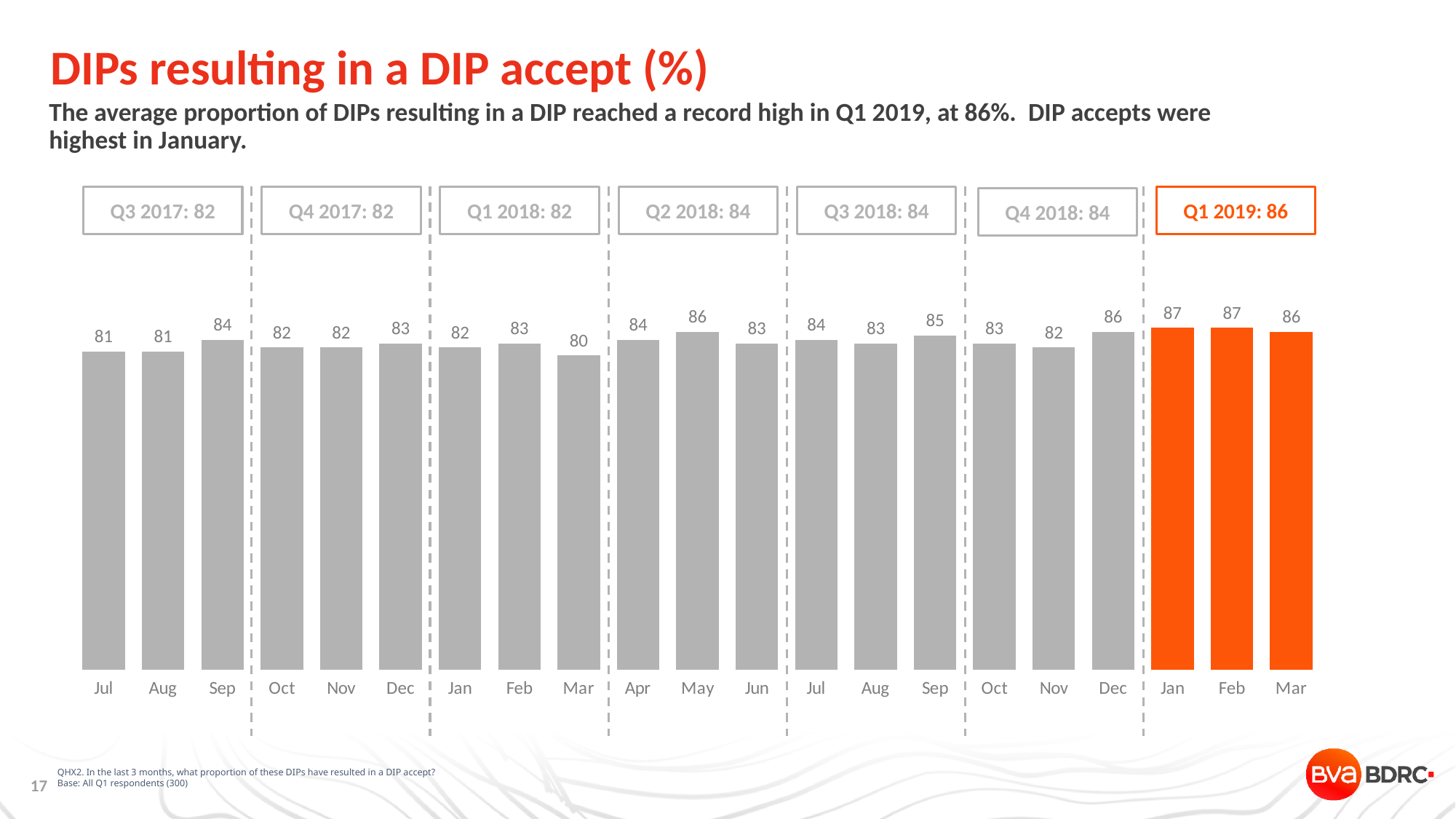
What is the value for Jan in Q1 2019? 87 What is the quarterly average shown for Q1 2019? 86 What is the difference between the values for Sep 2017 and Jul 2017? 3 How many bars are plotted on the chart? 21 What kind of chart is shown on the slide? Bar chart Which month has the lowest value on the chart? Mar (Q1 2018) Which quarter's bars are highlighted in orange? Q1 2019 What is the value for Mar in Q1 2018? 80 Which is larger, the value for Sep in Q3 2018 or the value for Aug in Q3 2018? Sep What is the value for May in Q2 2018? 86 What is the value for Dec in Q4 2018? 86 What is the difference between the values for Jan 2019 and Mar 2018? 7